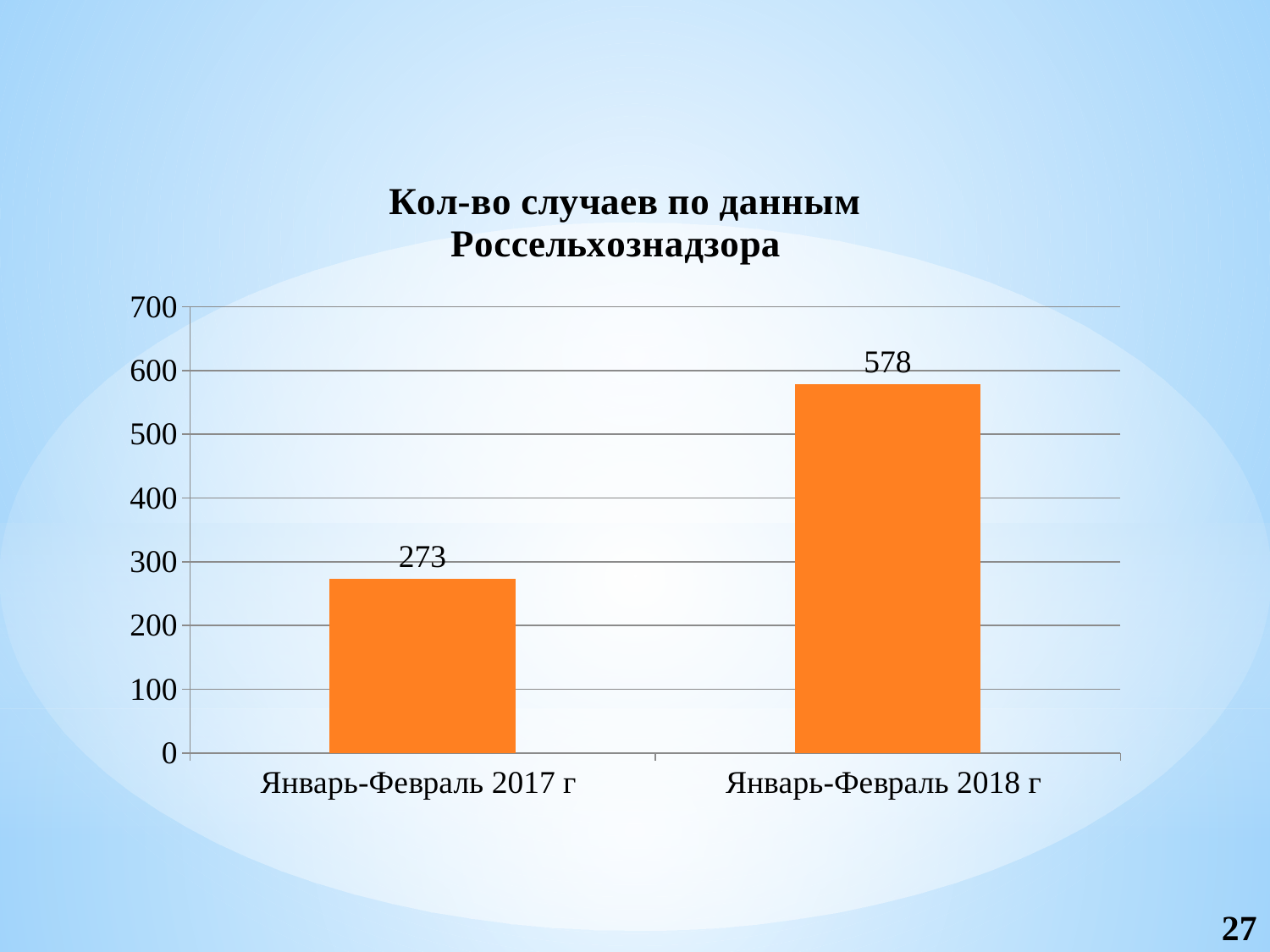
Is the value for Январь-Февраль 2018 г greater or less than 500? greater What kind of chart is shown on the slide? bar chart What is the value for Январь-Февраль 2017 г? 273 What is the difference between the values for Январь-Февраль 2018 г and Январь-Февраль 2017 г? 305 Is the value for Январь-Февраль 2017 г greater or less than 300? less Which is larger: the value for Январь-Февраль 2017 г or for Январь-Февраль 2018 г? Январь-Февраль 2018 г How many categories are shown on the chart? 2 What is the title of the chart? Кол-во случаев по данным Россельхознадзора Which category has the highest value? Январь-Февраль 2018 г Which category has the lowest value? Январь-Февраль 2017 г What is the value for Январь-Февраль 2018 г? 578 Do the values rise or fall from Январь-Февраль 2017 г to Январь-Февраль 2018 г? rise